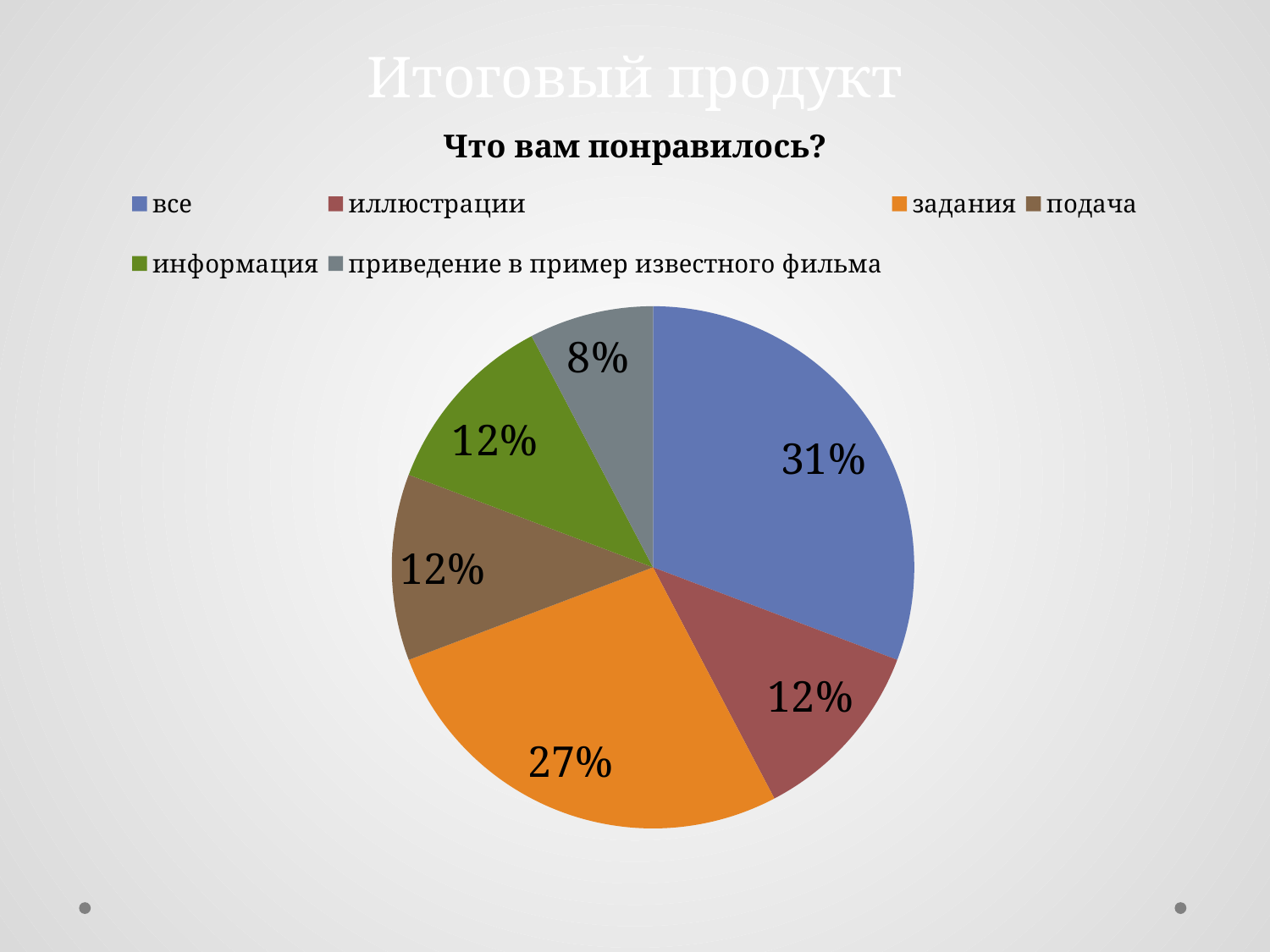
What share of the pie is the slice for "приведение в пример известного фильма"? 8% What is the difference between the share for "все" and the share for "приведение в пример известного фильма"? 23% Which category has the smallest slice? приведение в пример известного фильма What kind of chart is shown on the slide? pie chart What is the chart's title? Что вам понравилось? What colour is the slice for "задания"? orange What share of the pie is the slice for "все"? 31% What share of the pie is the slice for "задания"? 27% How many categories does the legend list? 6 Which category has the largest slice? все Which is larger, the slice for "все" or the slice for "задания"? все